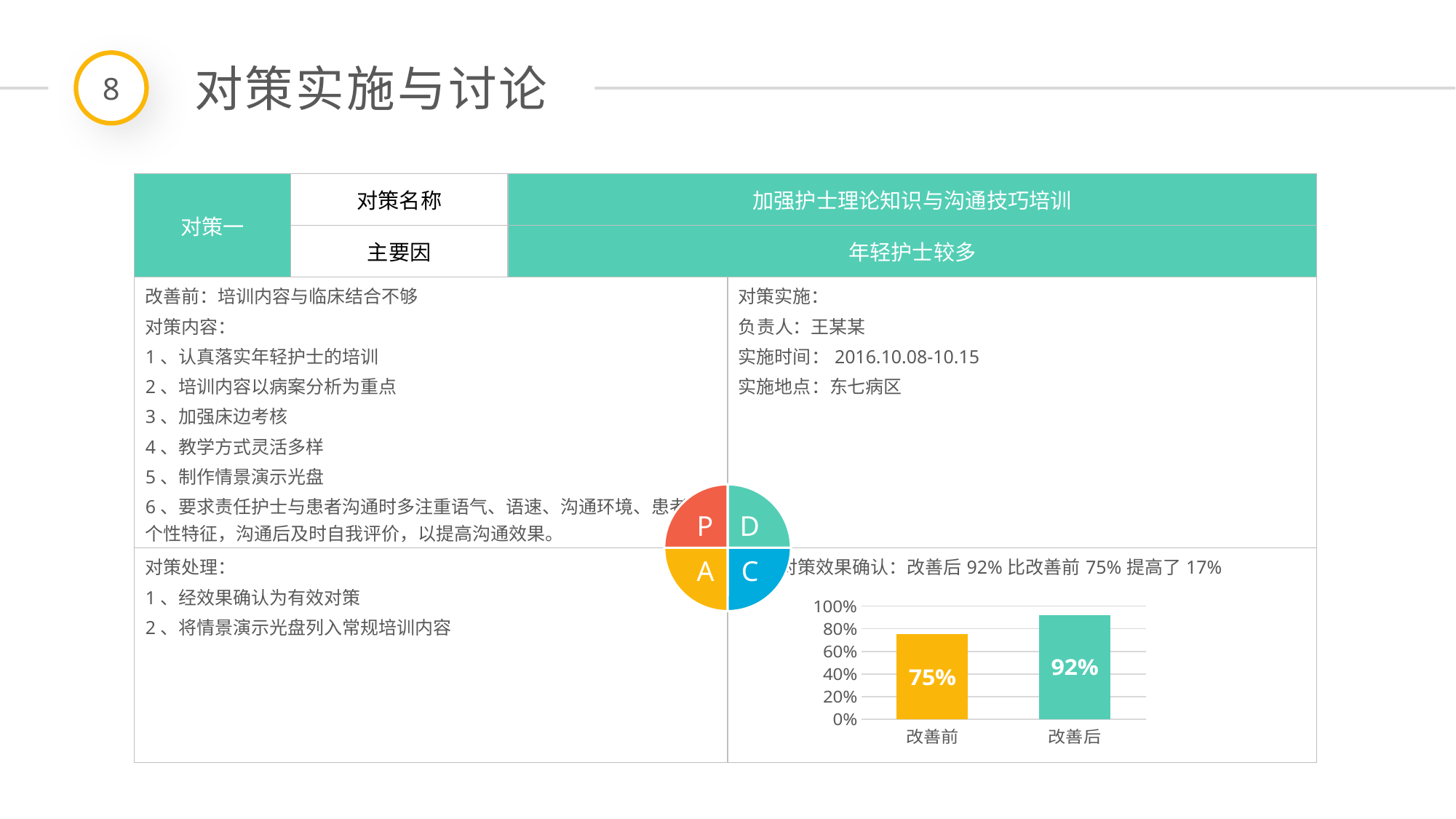
Which is larger, the value for 改善前 or the value for 改善后? 改善后 What is the value for 改善后 in the bar chart? 92% Is the value for 改善前 greater or less than 80%? less Which category has the highest value in the bar chart? 改善后 What kind of chart is shown on the slide? bar chart What is the difference between the values for 改善后 and 改善前? 17% What is the value for 改善前 in the bar chart? 75% Do the values rise or fall from 改善前 to 改善后? rise How many categories are shown in the bar chart? 2 Which category has the lowest value in the bar chart? 改善前 Is the value for 改善后 greater or less than 80%? greater What colour is the bar for 改善后? green